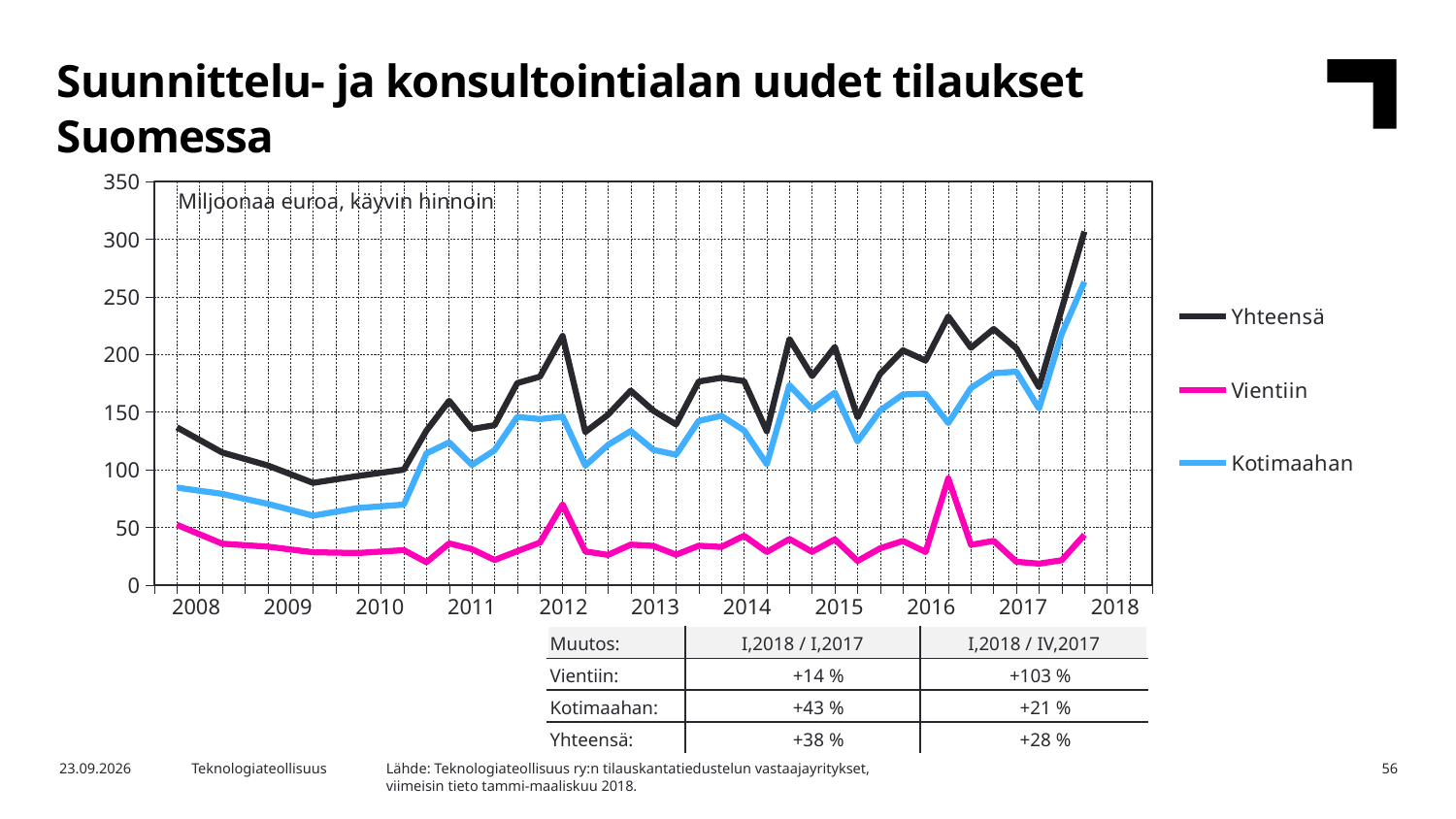
Which series are listed in the chart legend? Yhteensä, Vientiin, Kotimaahan Is the peak value for Vientiin in 2016 greater or less than 100? less Does the Yhteensä line rise or fall from 2008 to 2009? fall Is the value for Yhteensä at the last point in 2018 greater or less than 250? greater What unit is stated in the text inside the chart area? Miljoonaa euroa, käyvin hinnoin How many series does the legend list? 3 Which series has the lowest values throughout the chart? Vientiin Is the lowest value for Yhteensä in 2009 greater or less than 100? less Which is larger at the start of 2008, Kotimaahan or Vientiin? Kotimaahan Which series has the highest values throughout the chart? Yhteensä What kind of chart is shown on the slide? line chart